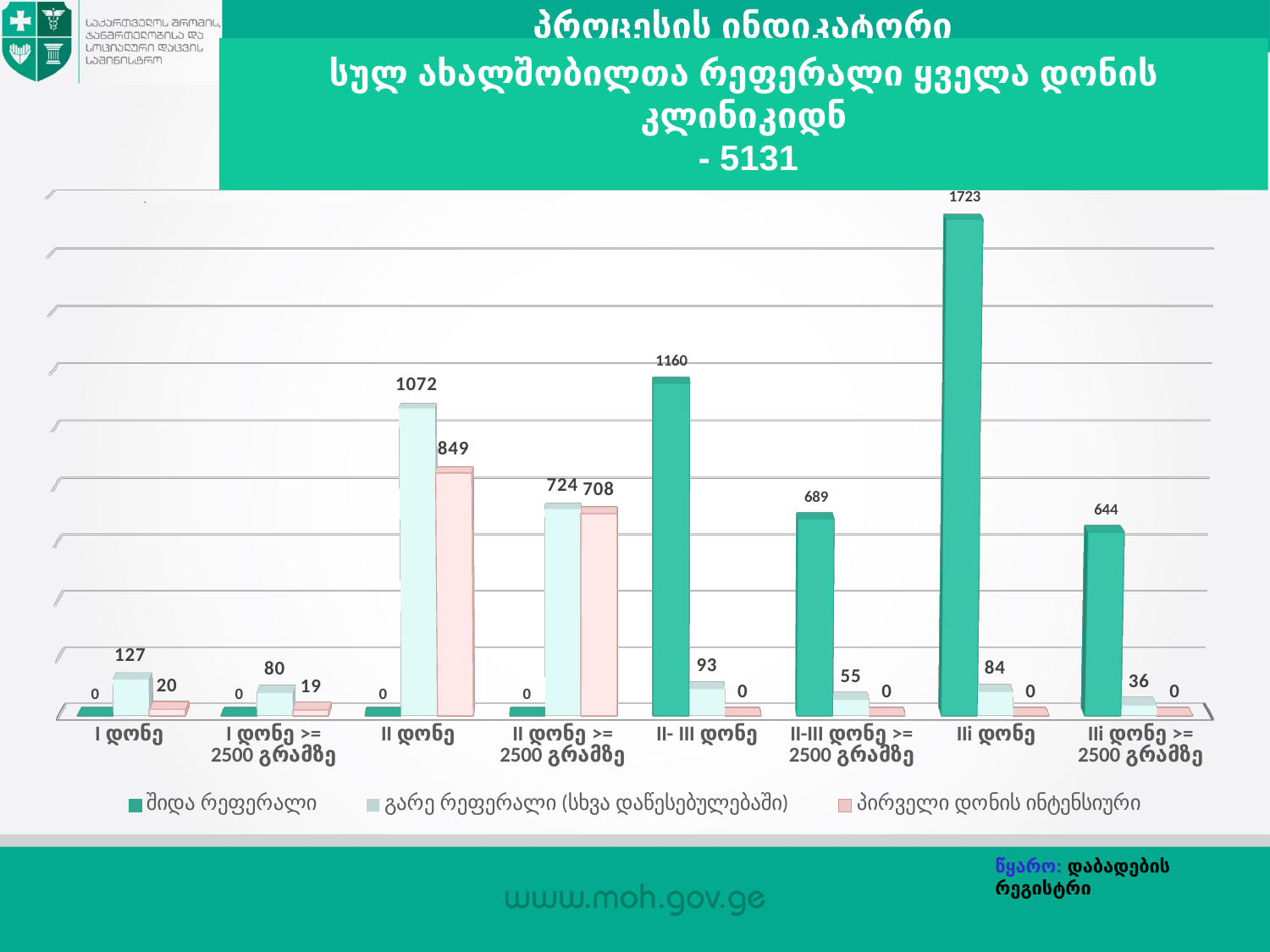
How many categories are shown on the x axis? 8 Which is larger: შიდა რეფერალი for II- III დონე or შიდა რეფერალი for III დონე >= 2500 გრამზე? II- III დონე What is the value of შიდა რეფერალი for II-III დონე >= 2500 გრამზე? 689 What is the difference between the გარე რეფერალი and პირველი დონის ინტენსიური values for II დონე? 223 Which category has the lowest non-zero value for გარე რეფერალი (სხვა დაწესებულებაში)? III დონე >= 2500 გრამზე What is the value of პირველი დონის ინტენსიური for II დონე >= 2500 გრამზე? 708 What is the value of გარე რეფერალი (სხვა დაწესებულებაში) for II დონე? 1072 Which category has the highest value for შიდა რეფერალი? III დონე What kind of chart is shown on the slide? Bar chart What is the total of the three series for I დონე? 147 What is the value of შიდა რეფერალი for III დონე? 1723 How many series does the legend list? 3